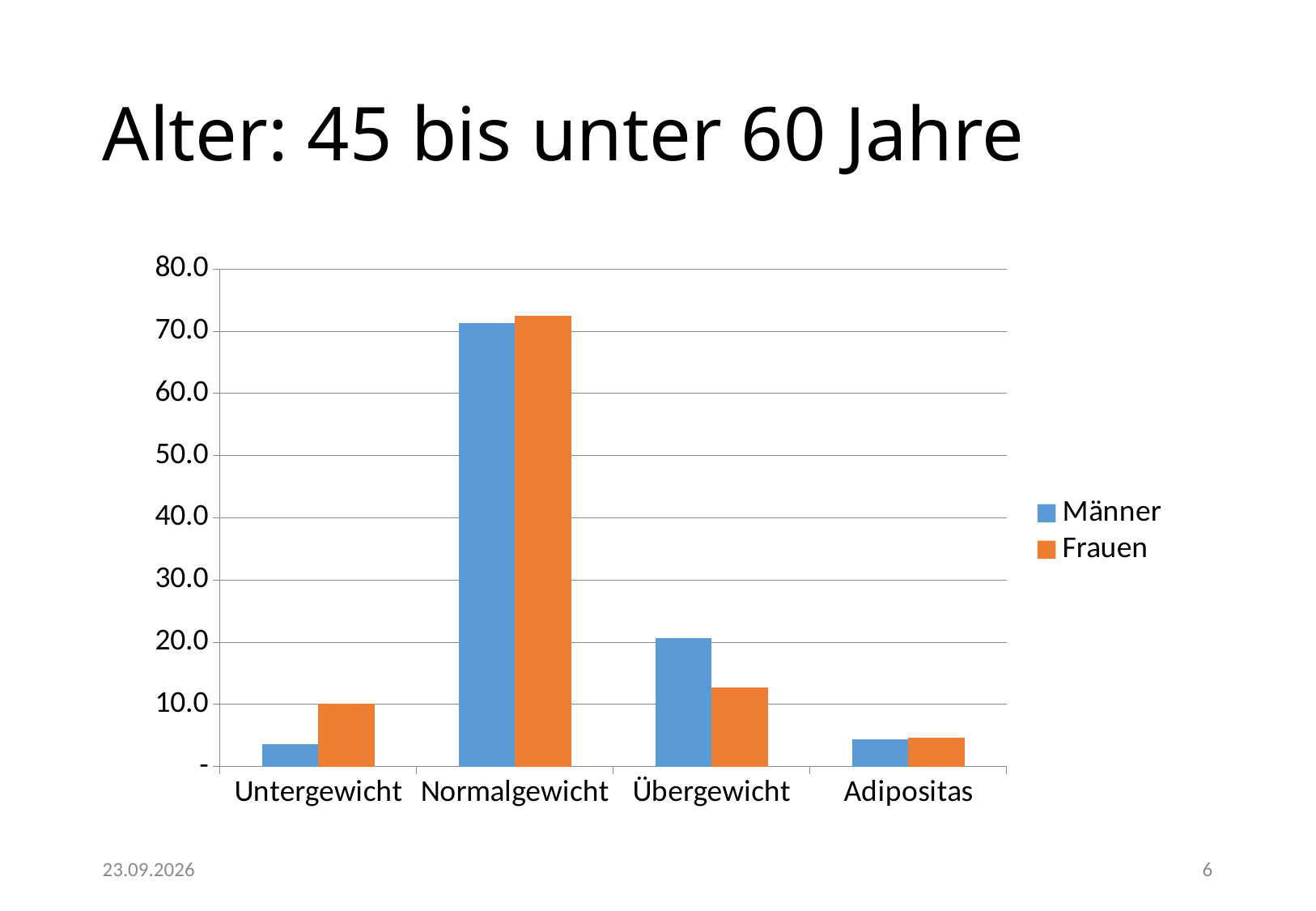
Is the value for Männer in Übergewicht greater or less than 20.0? greater How many categories are shown on the x axis? 4 Which category has the highest value for Frauen? Normalgewicht How many series does the legend list? 2 Which category has the lowest value for Frauen? Adipositas What kind of chart is shown on the slide? bar chart Is the value for Männer in Normalgewicht greater or less than 70.0? greater Which colour represents the Frauen series in the legend? orange For Übergewicht, which series has the larger value, Männer or Frauen? Männer For Untergewicht, which series has the larger value, Männer or Frauen? Frauen Which category has the highest value for Männer? Normalgewicht Which category has the lowest value for Männer? Untergewicht